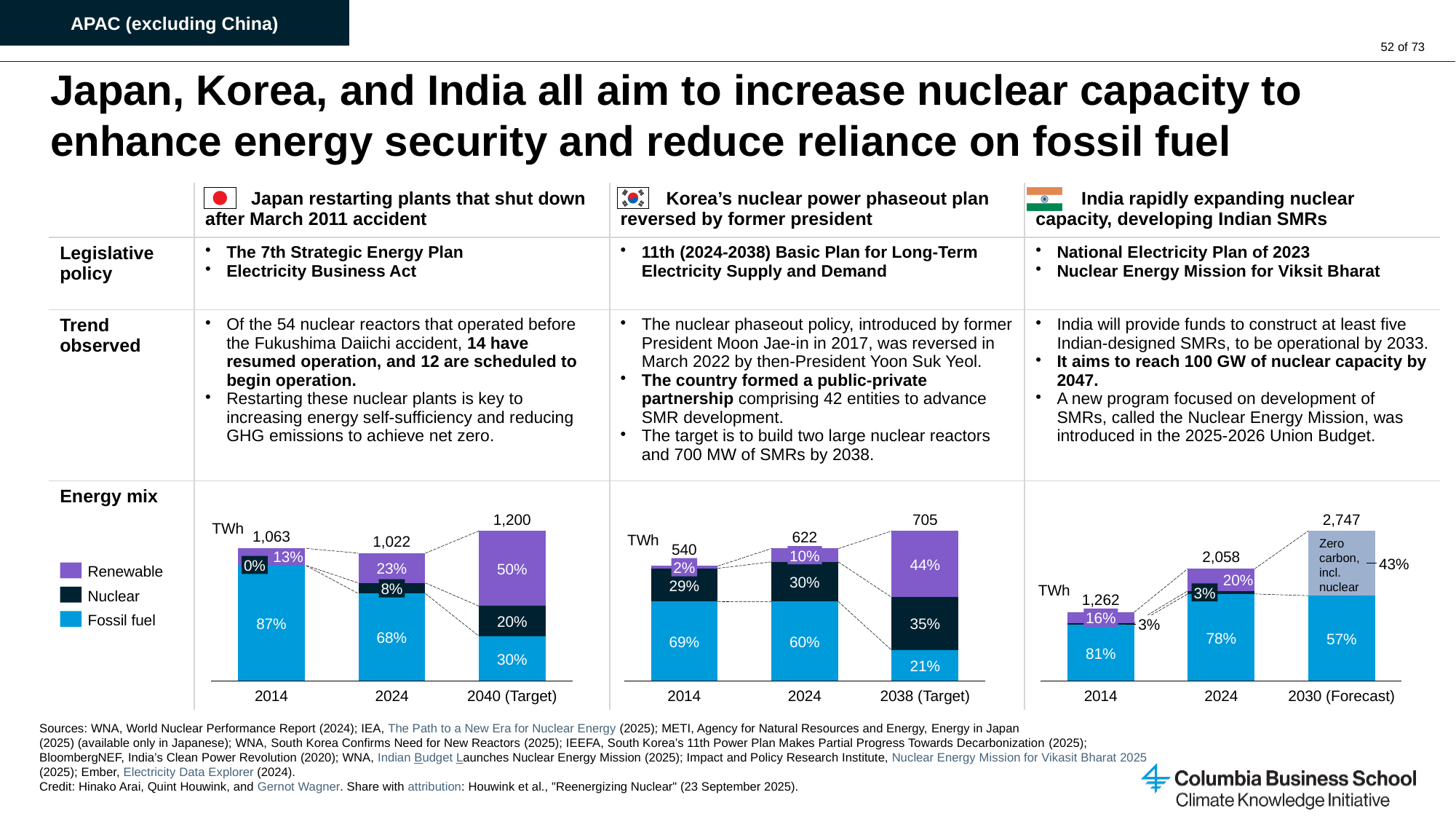
In the Korea energy mix chart (middle), what is the fossil fuel share in 2014? 69% In the India energy mix chart (right), what is the total TWh shown for 2030 (Forecast)? 2,747 In the India energy mix chart (right), is the total TWh for 2024 larger or smaller than the total for 2014? larger In the Japan energy mix chart (left), what is the total generation in TWh shown for 2014? 1,063 In the Korea energy mix chart (middle), which year has the highest total TWh? 2038 (Target) In the Japan energy mix chart (left), what is the nuclear share in 2024? 8% In the Korea energy mix chart (middle), what is the total TWh shown for the 2038 (Target) bar? 705 What kind of chart is used to show the energy mix for each country? Stacked bar chart How many series does the energy mix legend list? 3 In the India energy mix chart (right), what is the fossil fuel share in 2024? 78% In the Japan energy mix chart (left), by how many percentage points does the fossil fuel share fall from 2014 to 2040 (Target)? 57 percentage points In the Japan energy mix chart (left), what share of the 2040 (Target) bar is renewable? 50%